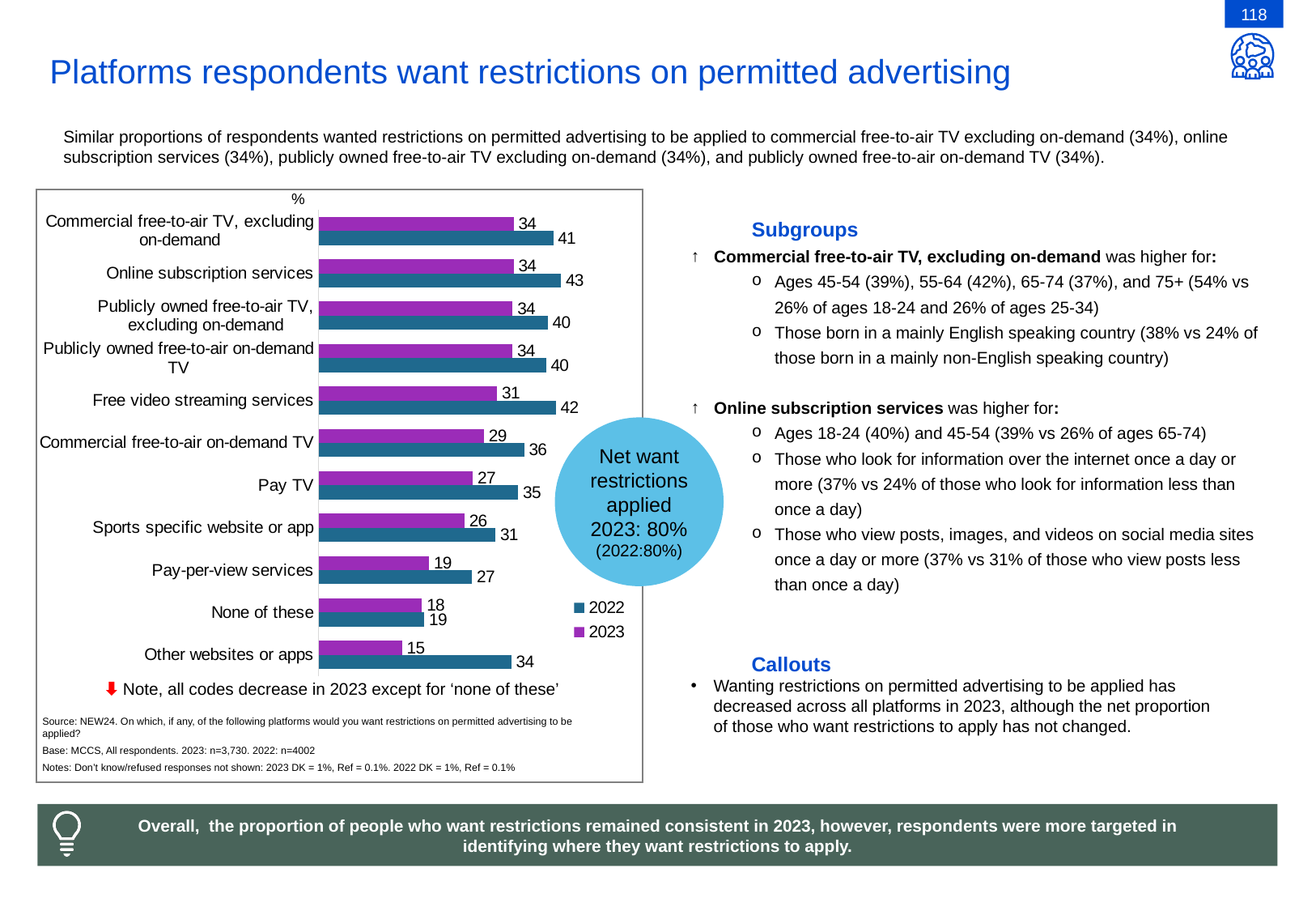
What is the 2023 value for Free video streaming services? 31 Which category has the lowest 2022 value? None of these What is the 2022 value for Pay TV? 35 Which category has the highest 2022 value? Online subscription services What is the difference between the 2022 and 2023 values for Other websites or apps? 19 What kind of chart is shown on the slide? Bar chart How many categories are shown in the chart? 11 What is the difference between the 2022 and 2023 values for Pay-per-view services? 8 How many series does the legend list? 2 Which category has the lowest 2023 value? Other websites or apps What is the 2022 value for Other websites or apps? 34 Which is larger for Sports specific website or app: the 2022 value or the 2023 value? 2022